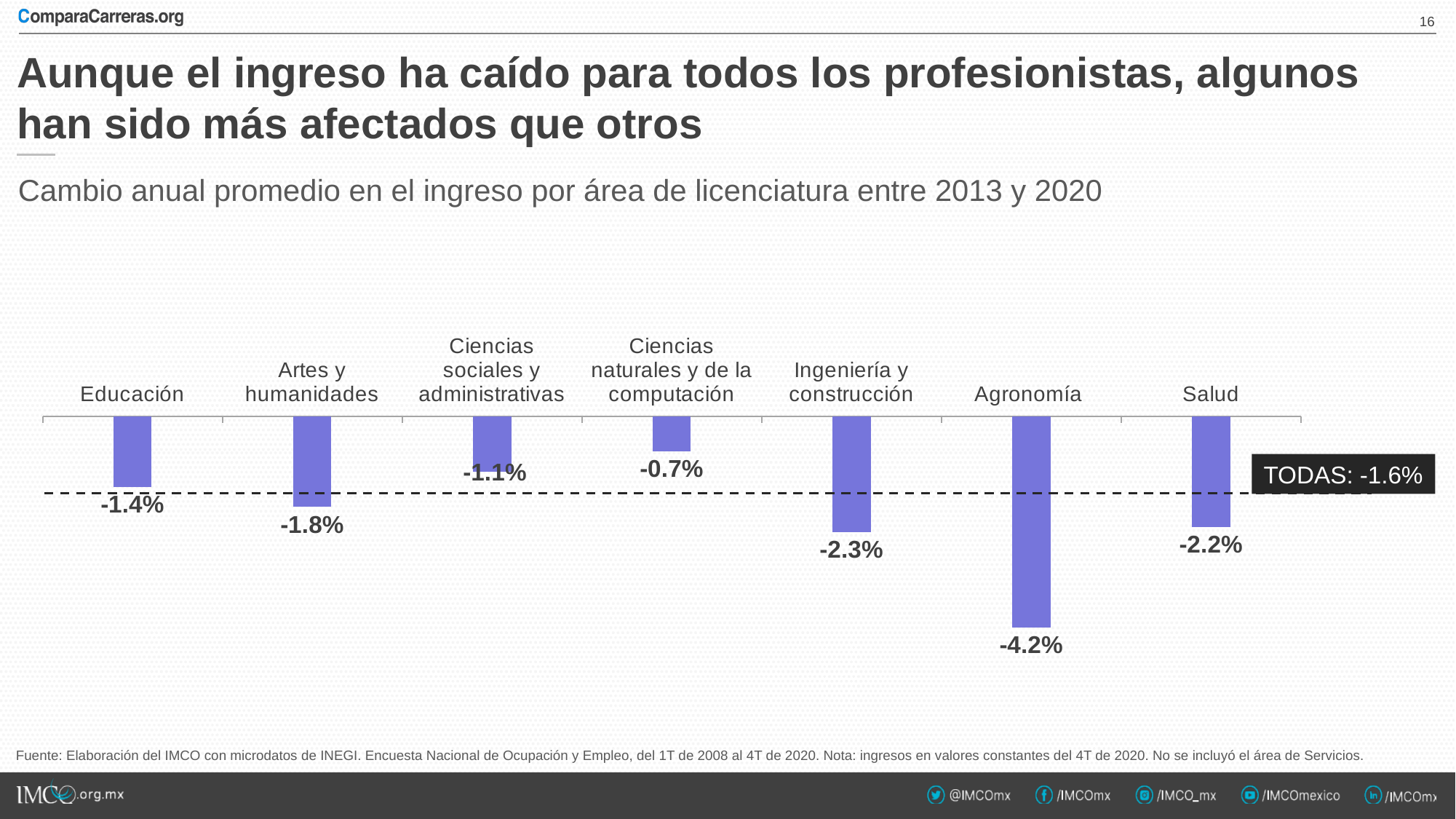
Which has a larger decline, Artes y humanidades or Ciencias sociales y administrativas? Artes y humanidades Which area shows the smallest decline (the least negative value)? Ciencias naturales y de la computación What is the value for Ciencias naturales y de la computación? -0.7% What is the value for Ingeniería y construcción? -2.3% What is the value for Salud? -2.2% What kind of chart is shown on the slide? Bar chart How many areas of licenciatura are shown in the chart? 7 Which area shows the largest decline (the most negative value)? Agronomía What is the value for Agronomía? -4.2% What value does the dashed line labelled TODAS represent? -1.6% What is the value for Educación? -1.4% What is the difference between the values for Agronomía and Ingeniería y construcción? 1.9 percentage points